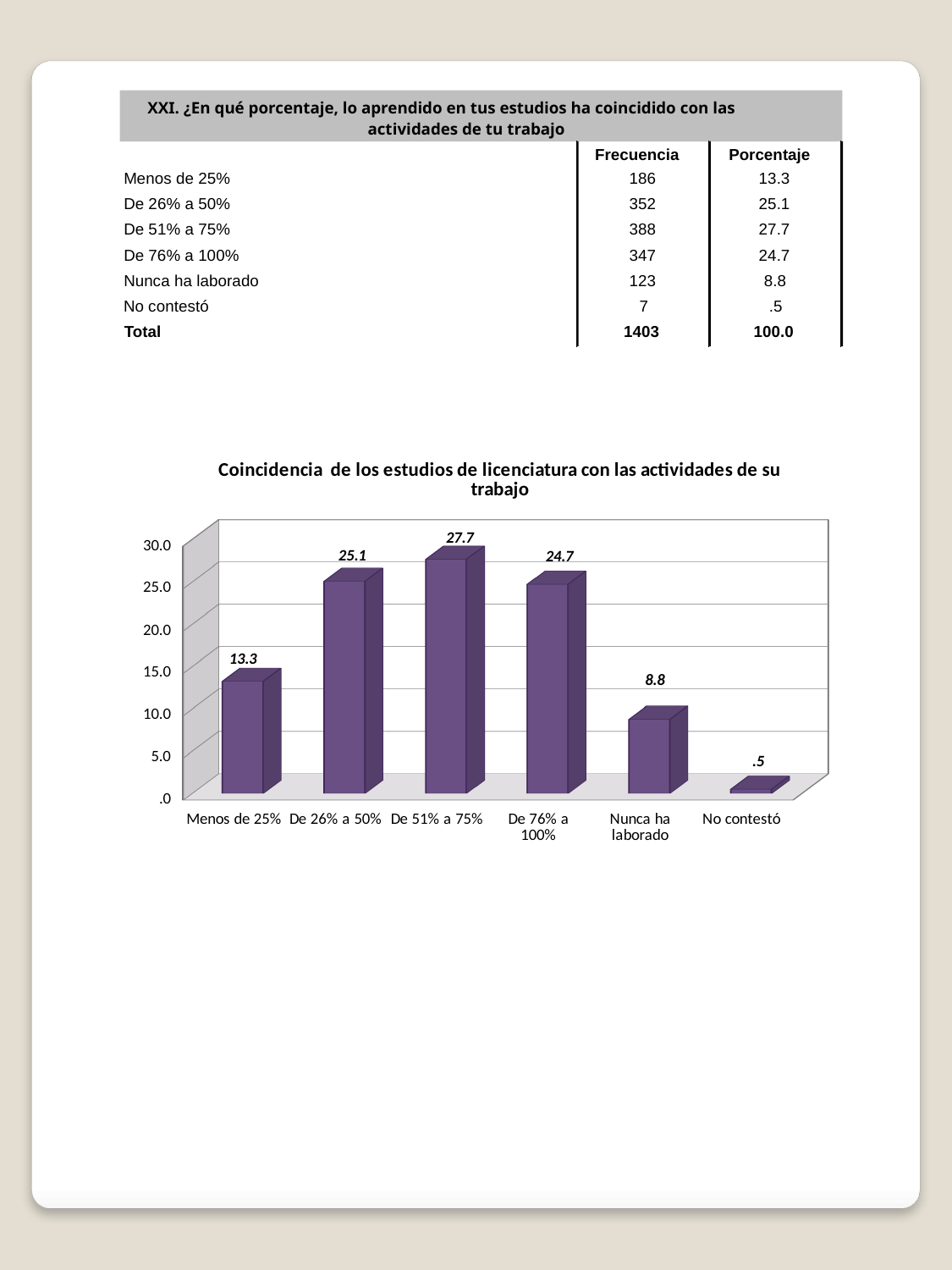
What is the value for 'Menos de 25%' in the chart? 13.3 Which category has the highest value in the chart? De 51% a 75% What is the title of the chart? Coincidencia de los estudios de licenciatura con las actividades de su trabajo How many categories are shown on the x axis of the chart? 6 What is the difference between the values for 'De 51% a 75%' and 'Menos de 25%'? 14.4 Is the value for 'Nunca ha laborado' greater or less than 10.0? less What is the value for 'Nunca ha laborado' in the chart? 8.8 Which is larger, the value for 'De 26% a 50%' or the value for 'De 76% a 100%'? De 26% a 50% What is the value for 'De 51% a 75%' in the chart? 27.7 Which category has the lowest value in the chart? No contestó What kind of chart is shown on the slide? bar chart What colour are the bars in the chart? purple